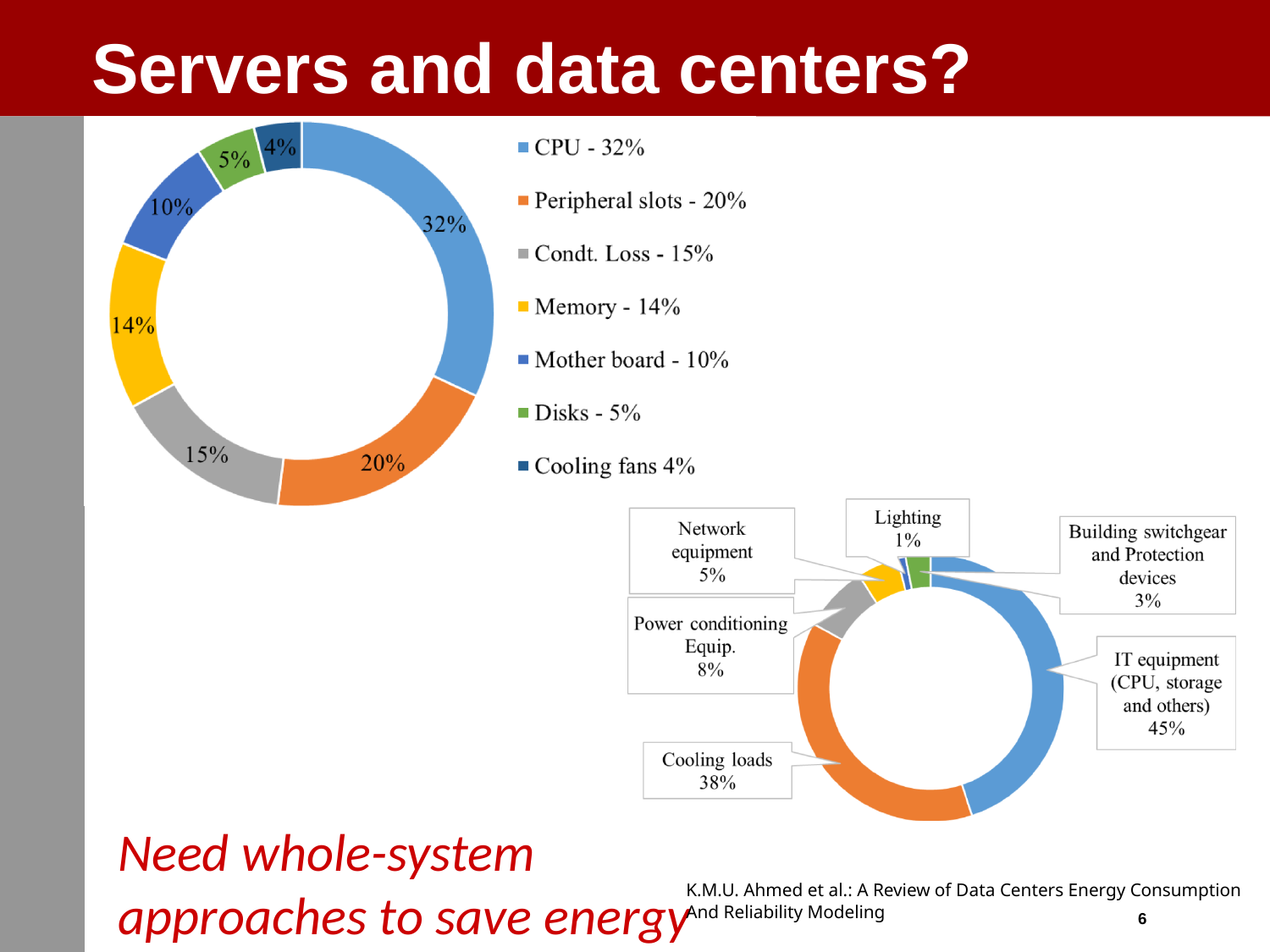
In the top-left chart, which category has the largest share? CPU In the bottom-right chart, which is larger: Network equipment or Building switchgear and Protection devices? Network equipment In the top-left chart, which category has the smallest share? Cooling fans In the bottom-right chart, what share is labelled for Power conditioning Equip.? 8% In the top-left chart, what share is labelled for Memory? 14% What kind of chart is the top-left chart? Doughnut chart In the top-left chart, how many categories does the legend list? 7 In the bottom-right chart, which category has the largest share? IT equipment (CPU, storage and others) In the top-left chart, what is the difference between the shares for Peripheral slots and Condt. Loss? 5% In the bottom-right chart, how many categories are labelled? 6 In the top-left chart, what share is labelled for CPU? 32% In the bottom-right chart, what share is labelled for Cooling loads? 38%